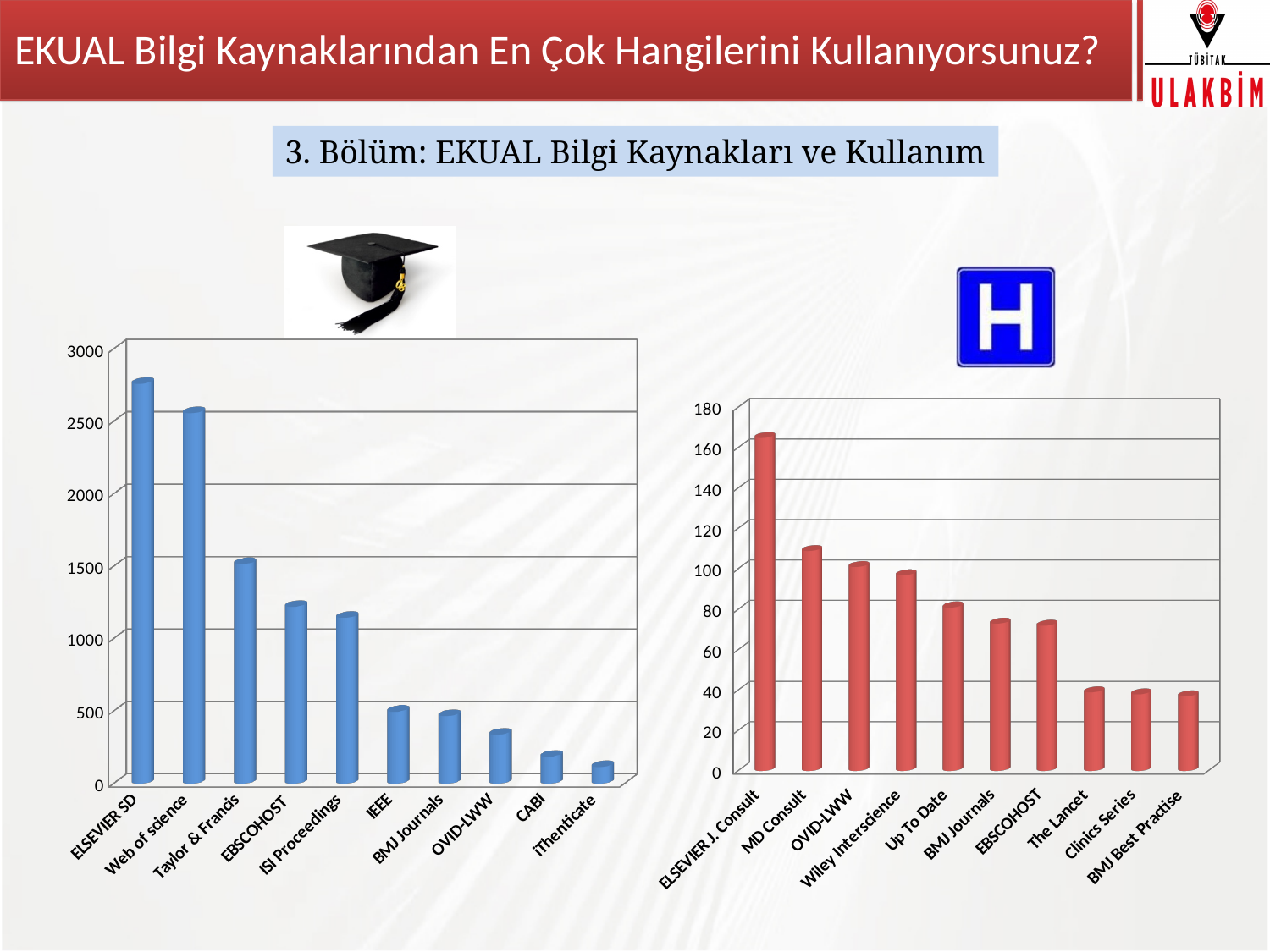
In the left chart, is the value for OVID-LWW greater or less than 500? less In the left chart, is the value for ELSEVIER SD greater or less than 2500? greater In the right chart, is the value for BMJ Journals greater or less than 80? less In the right chart, do the values generally rise or fall from left to right along the x axis? fall What kind of chart is the left chart on the slide? bar chart In the left chart, which category has the lowest value? iThenticate In the left chart, which category has the highest value? ELSEVIER SD In the right chart, which category has the highest value? ELSEVIER J. Consult How many categories are shown in the right chart? 10 How many categories are shown in the left chart? 10 In the left chart, which is larger, the value for Taylor & Francis or the value for IEEE? Taylor & Francis